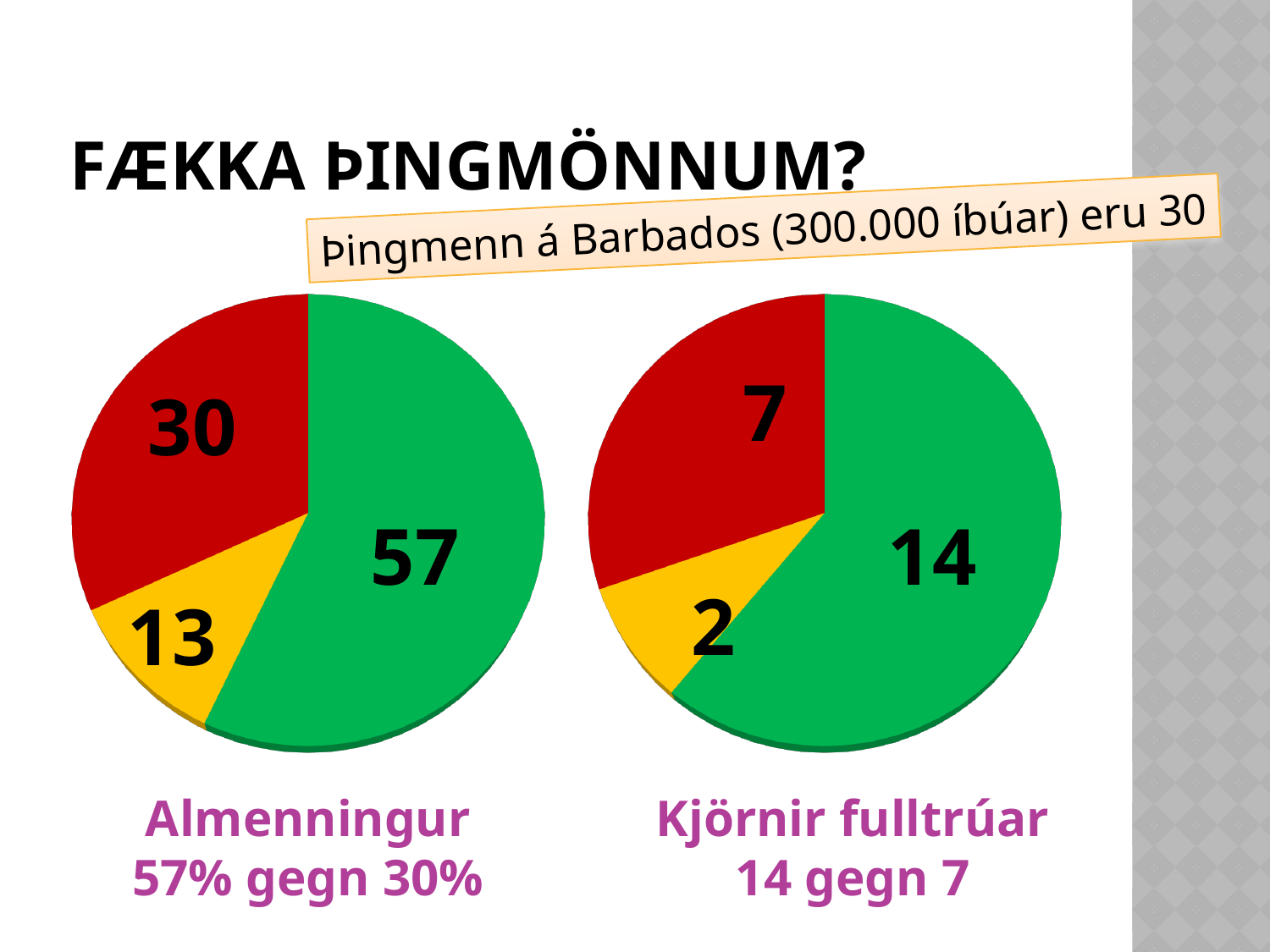
What kind of charts are shown on the slide? Pie charts How many pie charts are on the slide? 2 In the left pie chart (Almenningur), what is the value of the yellow slice? 13 How many slices does each pie chart have? 3 In the left pie chart (Almenningur), which colour slice is the largest? Green In the left pie chart (Almenningur), what is the value of the green slice? 57 In the right pie chart (Kjörnir fulltrúar), which colour slice is the smallest? Yellow In the right pie chart (Kjörnir fulltrúar), what is the value of the green slice? 14 In the left pie chart (Almenningur), what is the difference between the green slice and the red slice? 27 In the left pie chart (Almenningur), what is the value of the red slice? 30 In the right pie chart (Kjörnir fulltrúar), what is the difference between the green slice and the red slice? 7 In the right pie chart (Kjörnir fulltrúar), what is the value of the yellow slice? 2